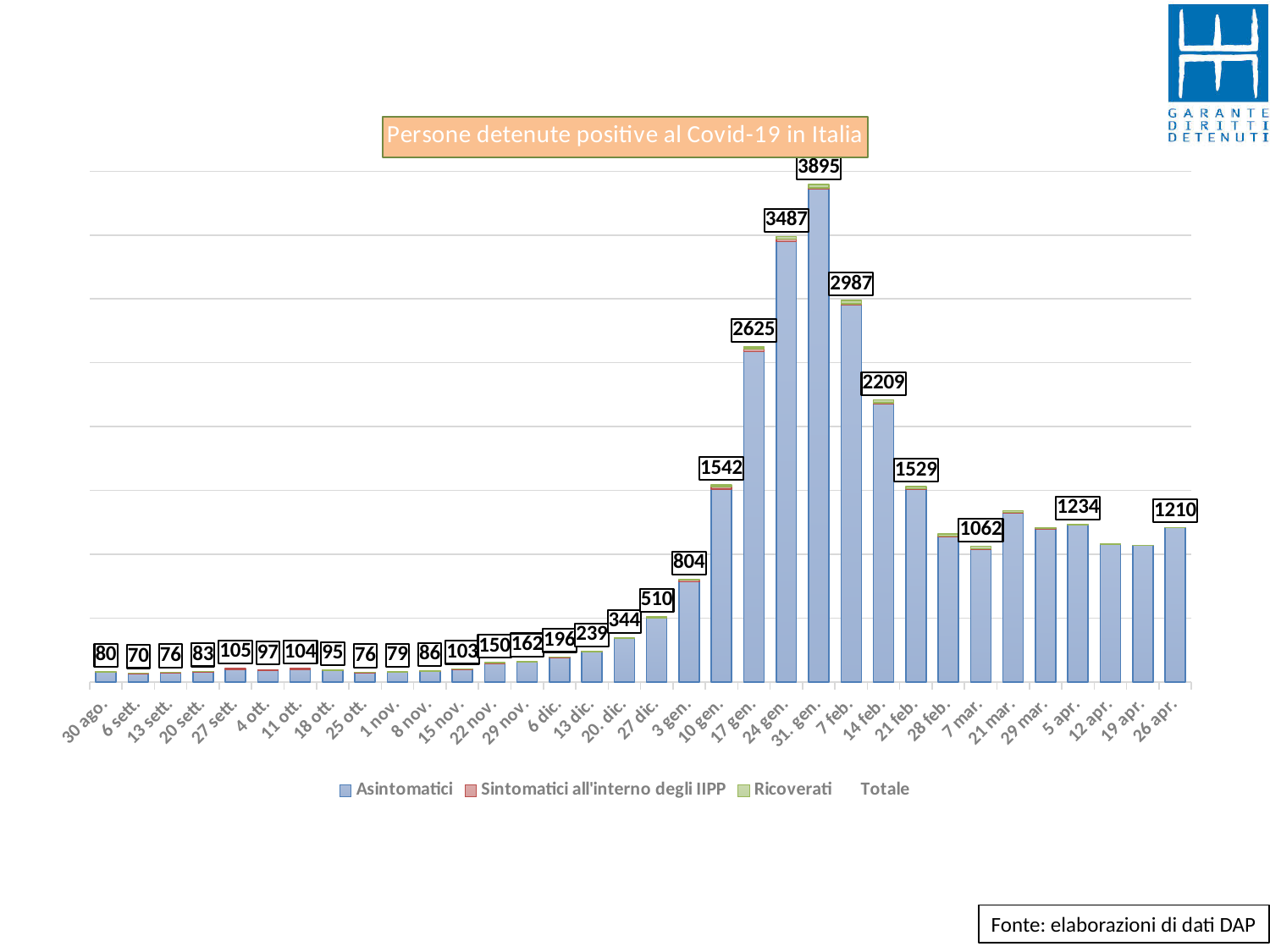
Which date has the highest total of positive detainees? 31. gen. How many series does the legend list? 4 What is the total value labelled for 3 gen.? 804 Which date has the lowest labelled total? 6 sett. Which has a larger labelled total, 5 apr. or 26 apr.? 5 apr. What is the difference between the totals for 31. gen. and 24 gen.? 408 How many dates are shown on the x axis? 34 What kind of chart is shown on the slide? bar chart What is the chart's title? Persone detenute positive al Covid-19 in Italia What is the total value labelled for 27 dic.? 510 Do the totals rise or fall from 31. gen. to 21 feb.? fall What is the total value labelled for 24 gen.? 3487